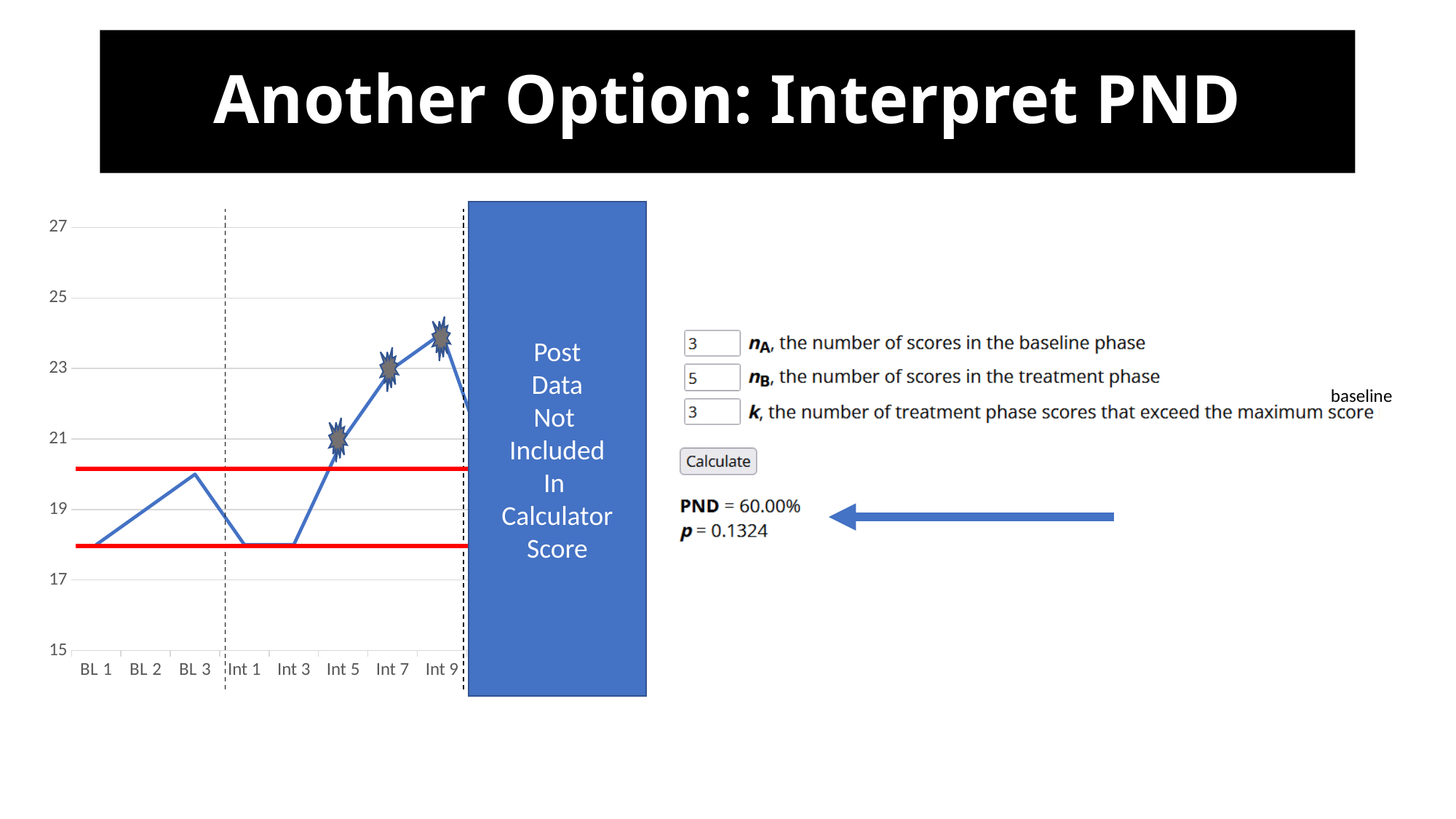
How many category labels are readable on the x axis? 8 Which of the labelled points has the highest value? Int 9 Is the value for BL 3 greater or less than 19? greater What is the value at Int 5? 21 Do the values rise or fall from Int 3 to Int 9? rise What colour are the two horizontal lines marking the baseline range on the chart? red Is the value for Int 1 greater or less than 19? less Is the value for BL 1 greater or less than 19? less What kind of chart is shown on the slide? line chart What is the value at Int 7? 23 Which is larger, the value at Int 7 or the value at BL 3? Int 7